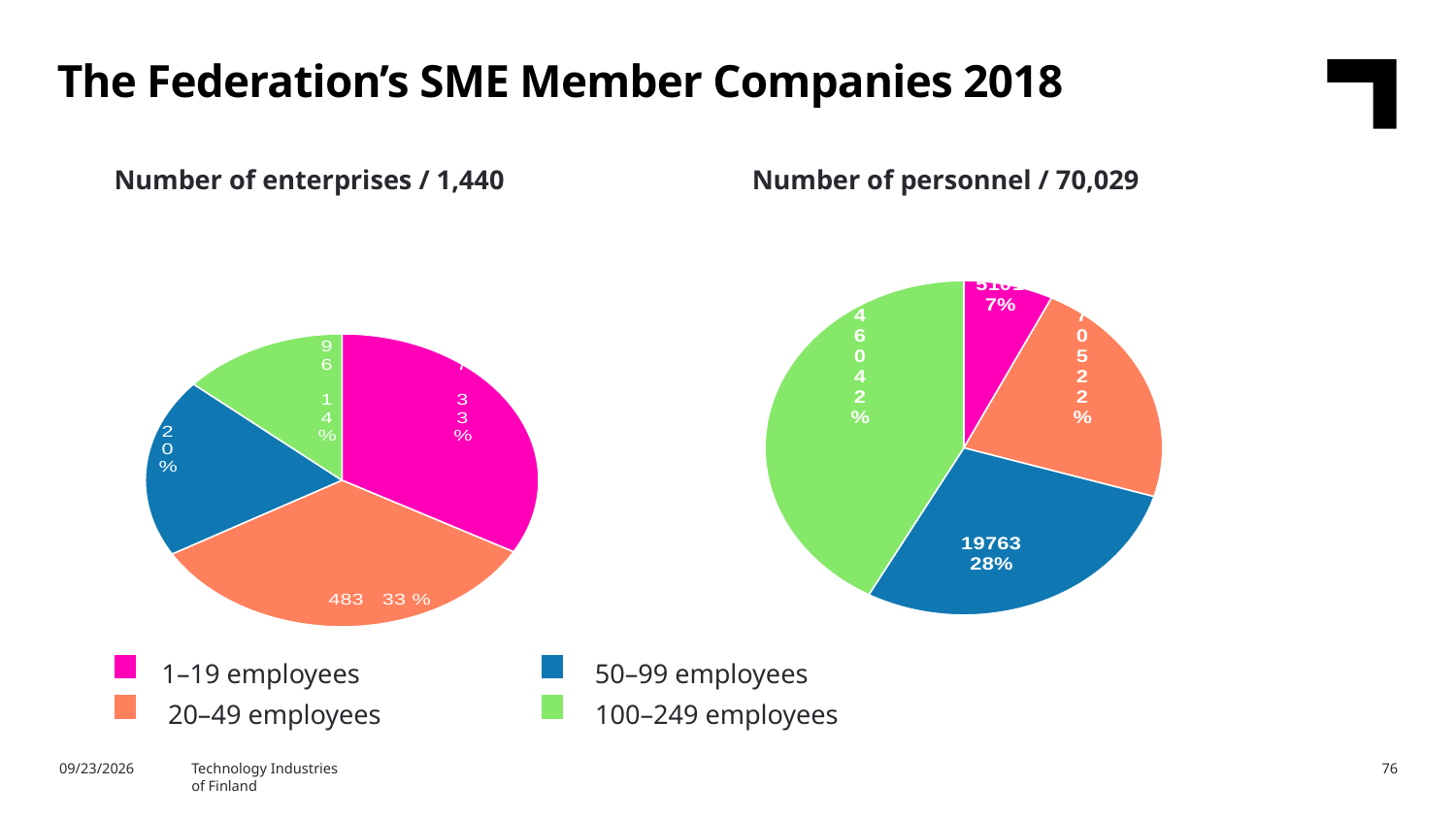
In the 'Number of personnel' pie chart, what share of personnel is in companies with 1–19 employees? 7% In the 'Number of personnel' pie chart, which employee-size category has the largest share? 100–249 employees How many employee-size categories does the legend list? 4 In the 'Number of enterprises' pie chart, what share of enterprises have 100–249 employees? 14% In the 'Number of enterprises' pie chart, which employee-size category has the smallest share? 100–249 employees In the 'Number of personnel' pie chart, which has the larger share: 50–99 employees or 20–49 employees? 50–99 employees In the 'Number of personnel' pie chart, how many personnel are in companies with 50–99 employees? 19763 What is the total number of personnel shown in the title of the right-hand pie chart? 70,029 In the 'Number of enterprises' pie chart, how many enterprises have 20–49 employees? 483 In the 'Number of enterprises' pie chart, what share of enterprises have 50–99 employees? 20% What kind of chart is used on this slide for the number of enterprises and the number of personnel? Pie chart